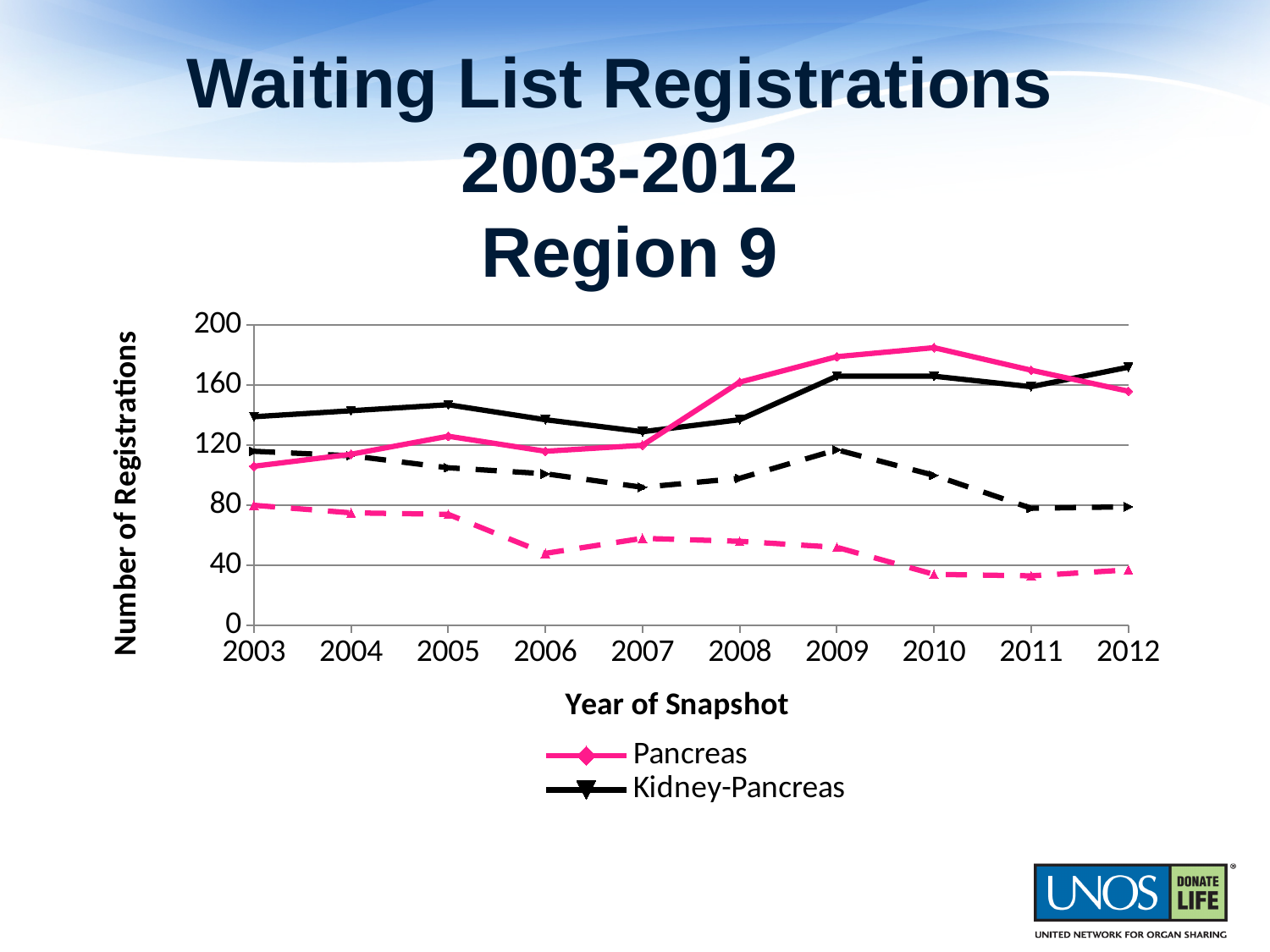
Is the value for Pancreas in 2003 greater or less than 120? less In which year is the Pancreas series at its highest? 2010 In which year is the Pancreas series at its lowest? 2003 How many series does the legend list? 2 What is the title of the x axis? Year of Snapshot Is the value for Pancreas in 2010 greater or less than 160? greater In which year is the Kidney-Pancreas series at its lowest? 2007 In 2003, which series has the larger value, Pancreas or Kidney-Pancreas? Kidney-Pancreas How many years are plotted along the x axis? 10 Does the Pancreas series rise or fall from 2010 to 2012? Fall Is the value for Kidney-Pancreas in 2005 greater or less than 160? less What kind of chart is shown on the slide? Line chart